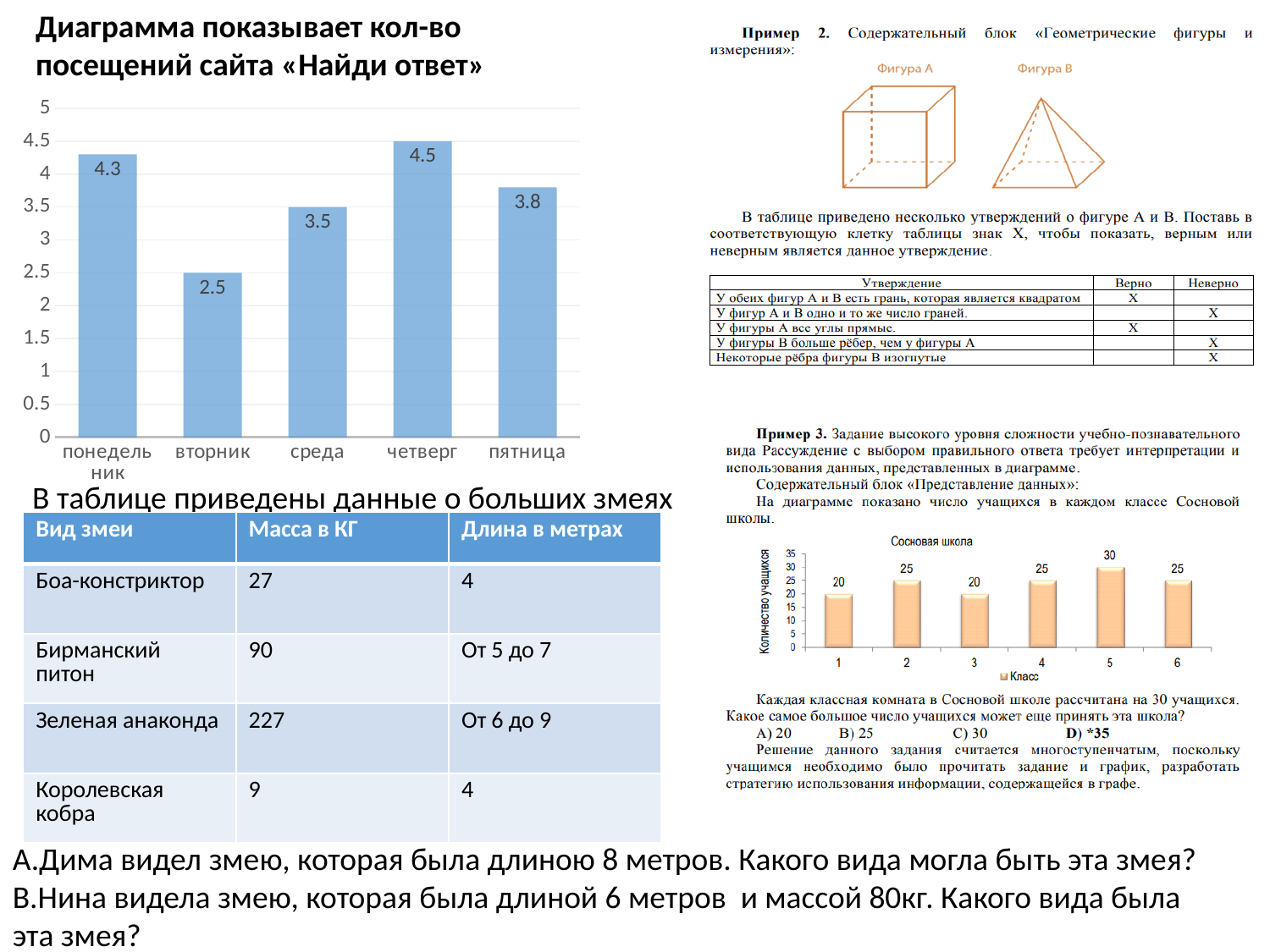
On the left chart about visits to the site «Найди ответ», how many days are shown on the x axis? 5 On the left chart about visits to the site «Найди ответ», what is the value for вторник? 2.5 On the chart titled «Сосновая школа», how many classes are shown on the x axis? 6 On the left chart about visits to the site «Найди ответ», which day has the highest value? четверг On the chart titled «Сосновая школа», what is the value for class 5? 30 On the left chart about visits to the site «Найди ответ», which is larger: the value for понедельник or the value for среда? понедельник What kind of chart is the left chart about visits to the site «Найди ответ»? bar chart On the chart titled «Сосновая школа», what is the difference between the values for class 5 and class 1? 10 On the chart titled «Сосновая школа», which class has the highest number of students? 5 On the left chart about visits to the site «Найди ответ», which day has the lowest value? вторник On the left chart about visits to the site «Найди ответ», what is the difference between the values for четверг and вторник? 2 On the left chart about visits to the site «Найди ответ», what is the value for пятница? 3.8